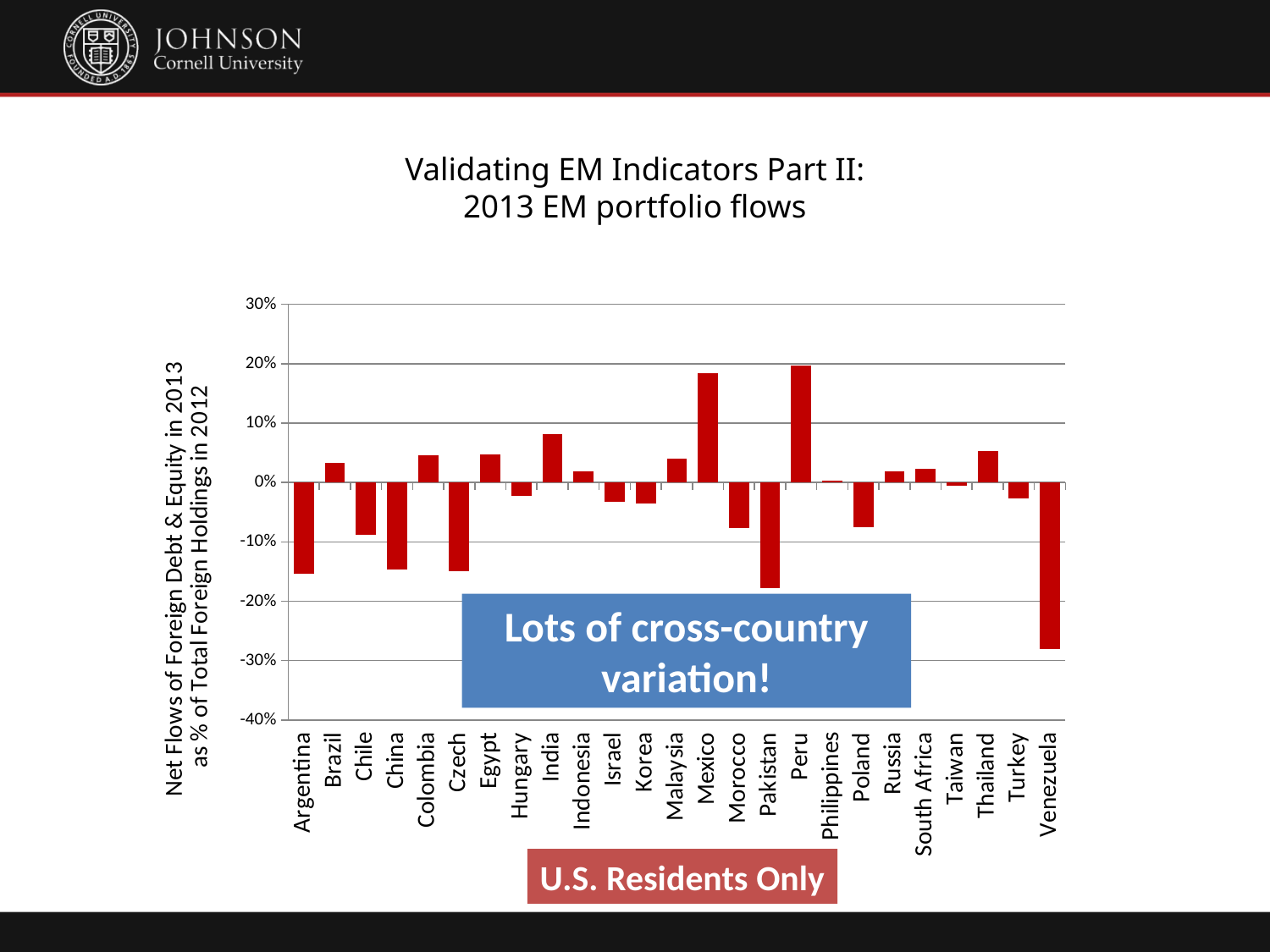
Which country has the lowest value in the chart? Venezuela Is the value for Pakistan greater or less than -10%? less Is the value for Venezuela greater or less than -20%? less Is the value for Argentina greater or less than -10%? less How many countries are shown on the x axis of the chart? 25 What kind of chart is shown on the slide? bar chart Which has the larger value, Pakistan or Venezuela? Pakistan What does the red label below the chart say? U.S. Residents Only What is the y-axis title of the chart? Net Flows of Foreign Debt & Equity in 2013 as % of Total Foreign Holdings in 2012 Which has the larger value, India or Brazil? India